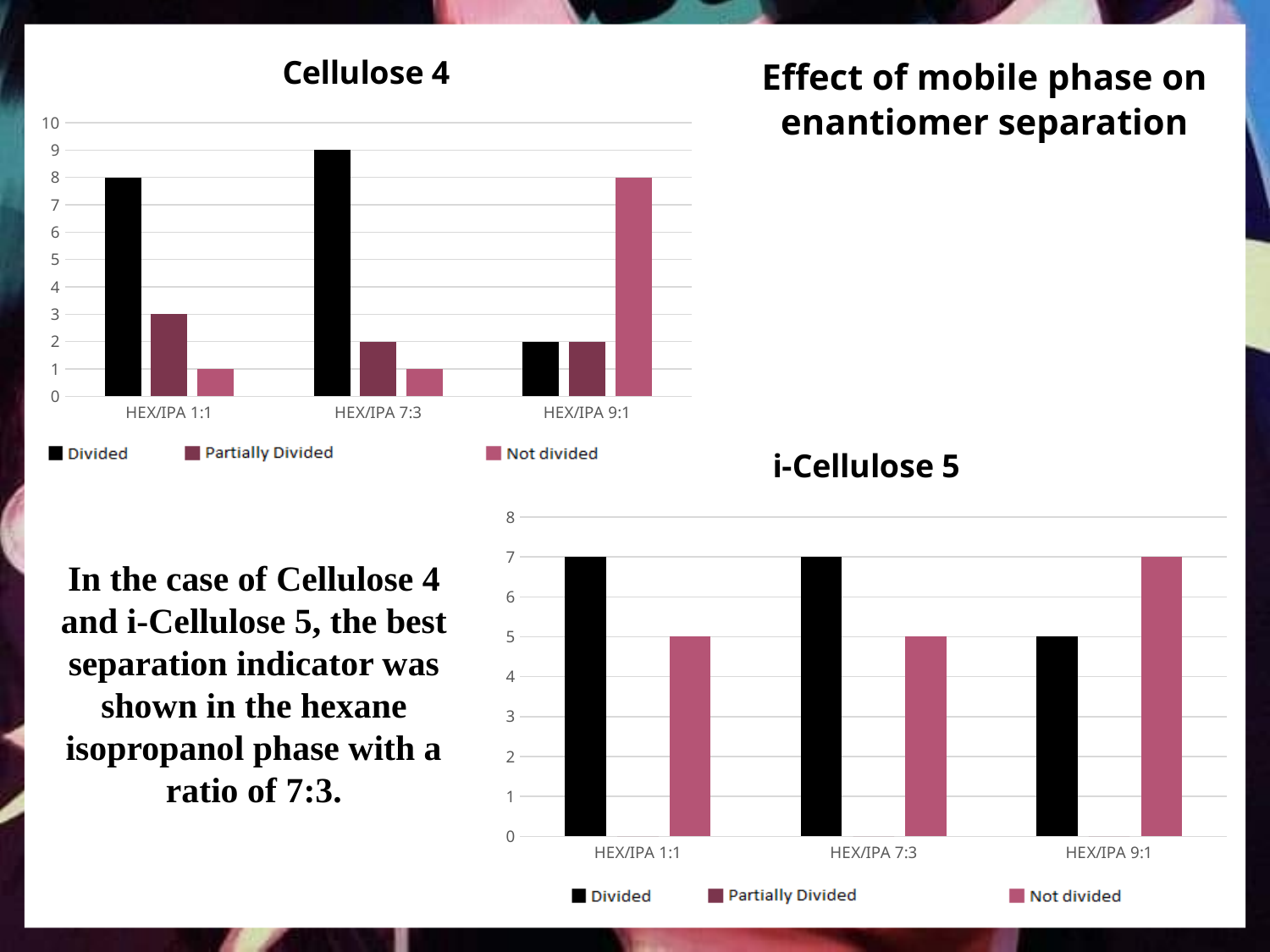
In the Cellulose 4 chart, what is the value of the Partially Divided series for HEX/IPA 1:1? 3 What kind of chart is the i-Cellulose 5 chart? Bar chart In the i-Cellulose 5 chart, how many mobile phase categories are shown on the x axis? 3 In the i-Cellulose 5 chart, which is larger for HEX/IPA 7:3: the Divided value or the Not divided value? Divided In the Cellulose 4 chart, what is the difference between the Divided value for HEX/IPA 1:1 and the Divided value for HEX/IPA 9:1? 6 In the Cellulose 4 chart, what is the value of the Not divided series for HEX/IPA 9:1? 8 In the Cellulose 4 chart, how many series does the legend list? 3 In the Cellulose 4 chart, which mobile phase has the highest Divided value? HEX/IPA 7:3 In the i-Cellulose 5 chart, what is the value of the Not divided series for HEX/IPA 9:1? 7 In the Cellulose 4 chart, what is the value of the Divided series for HEX/IPA 7:3? 9 In the i-Cellulose 5 chart, what is the value of the Divided series for HEX/IPA 1:1? 7 In the i-Cellulose 5 chart, does the Divided value rise or fall from HEX/IPA 7:3 to HEX/IPA 9:1? Fall